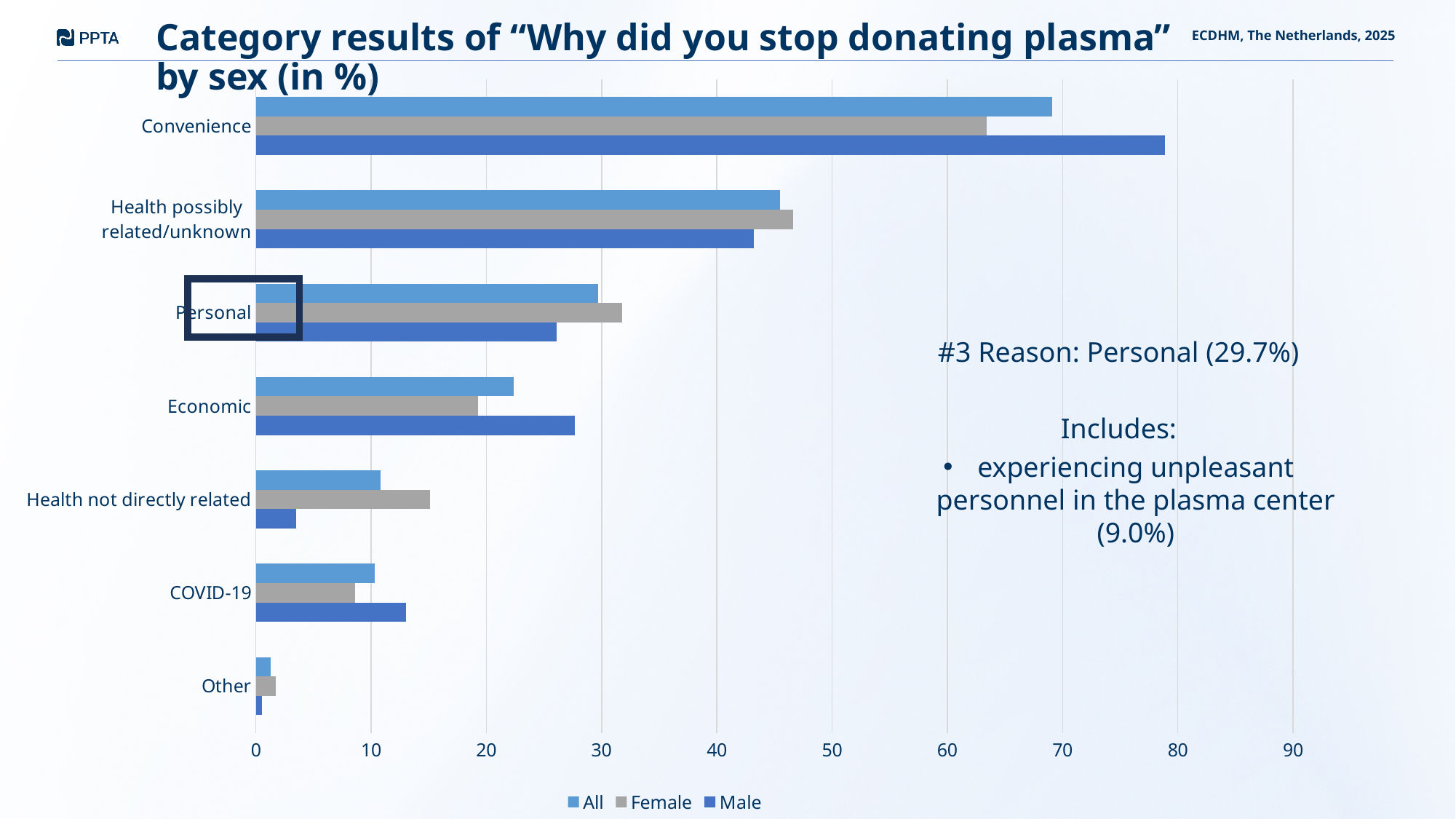
For Convenience, which is larger: the Male value or the Female value? Male Which category has the highest value for the Male series? Convenience According to the slide, what is the All value for the Personal category? 29.7% How many categories are shown on the chart? 7 Is the Female value for Health possibly related/unknown greater or less than 40? greater How many series does the legend list? 3 Is the Male value for Convenience greater or less than 70? greater What are the three series listed in the legend? All, Female, Male Is the Male value for Health not directly related greater or less than 10? less What kind of chart is shown on the slide? Bar chart Which category has the lowest value for the All series? Other For Economic, which is larger: the Male value or the Female value? Male